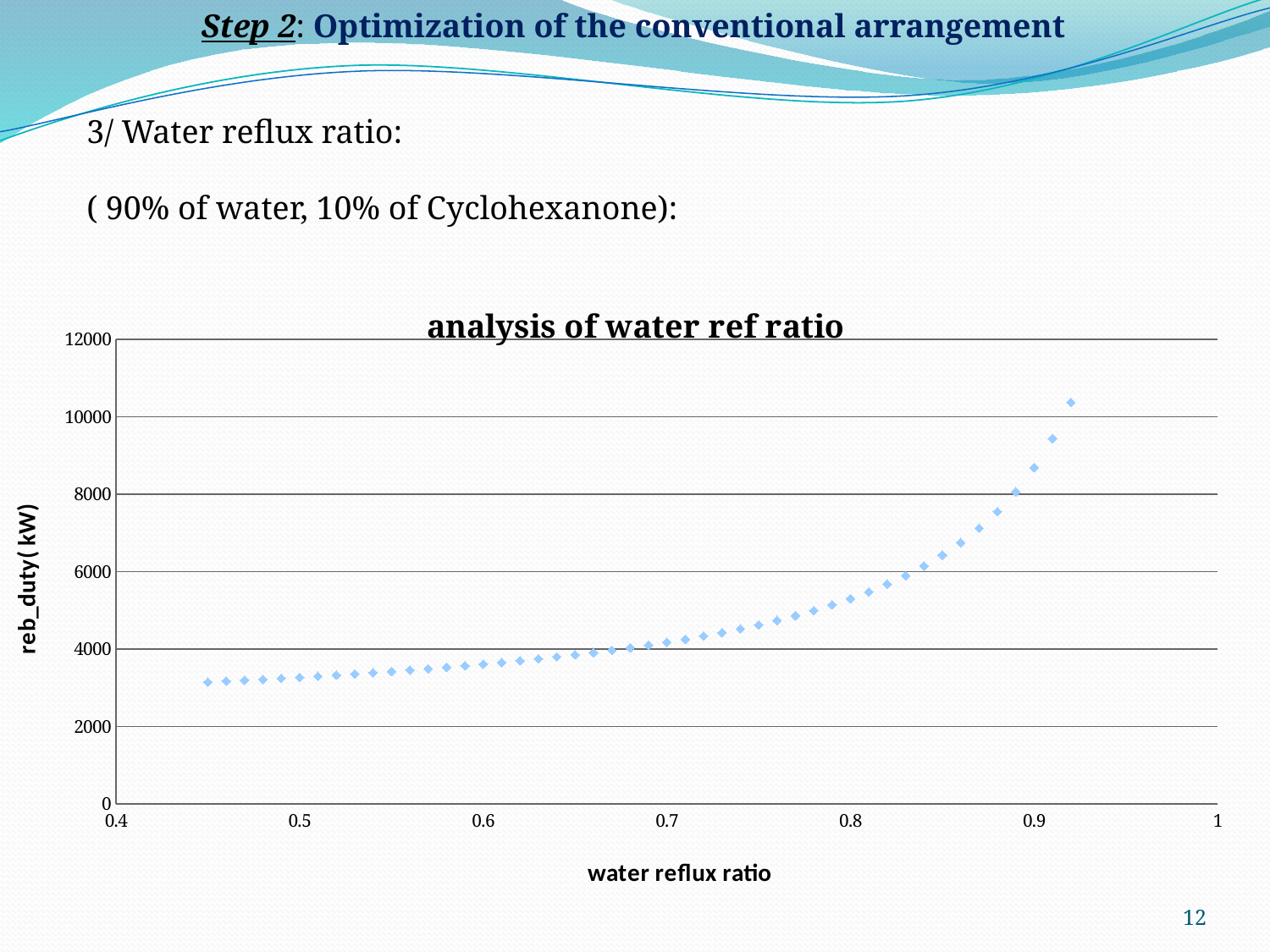
Which has the larger reb_duty value: the point at water reflux ratio 0.5 or the point at water reflux ratio 0.9? 0.9 Is the reb_duty value at a water reflux ratio of 0.6 greater or less than 4000? less What is the title of the chart? analysis of water ref ratio What kind of chart is shown on the slide? scatter chart Is the reb_duty value at a water reflux ratio of 0.8 greater or less than 6000? less Is the reb_duty value at a water reflux ratio of 0.45 greater or less than 2000? greater Does reb_duty rise or fall as the water reflux ratio increases along the x axis? rise What is the label of the vertical axis of the chart? reb_duty( kW)